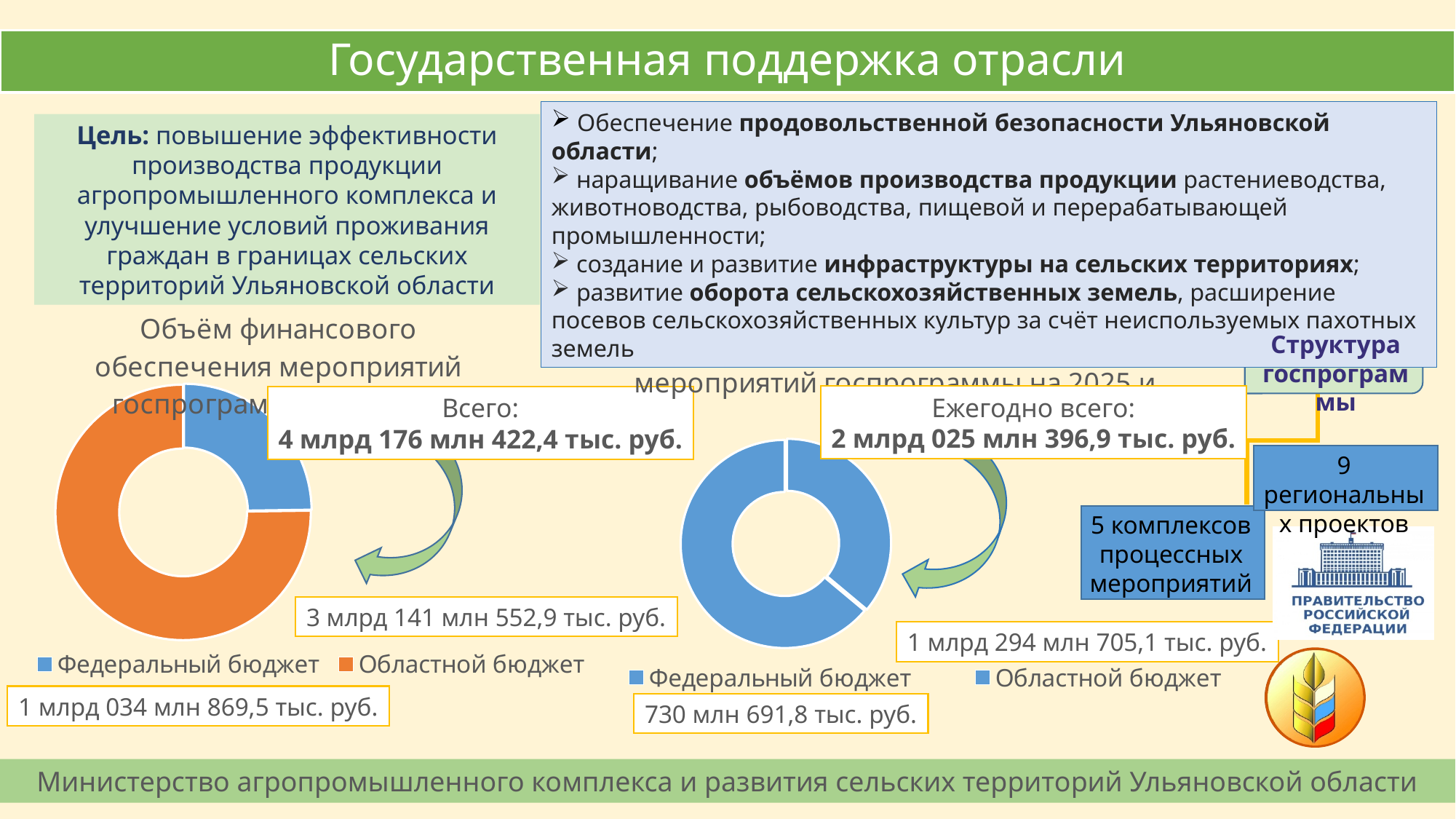
What type of chart is the left chart on the slide? doughnut chart How many slices does the right doughnut chart have? 2 On the right chart, what is the value for Федеральный бюджет? 730 млн 691,8 тыс. руб. How many series does the legend of the left chart list? 2 On the left chart, what is the value for Областной бюджет? 3 млрд 141 млн 552,9 тыс. руб. On the right chart, what is the annual total (Ежегодно всего) shown? 2 млрд 025 млн 396,9 тыс. руб. On the right chart, which budget has the smaller share? Федеральный бюджет On the left chart, what colour represents Областной бюджет? orange On the left chart, what is the total (Всего) shown? 4 млрд 176 млн 422,4 тыс. руб. On the right chart, what is the value for Областной бюджет? 1 млрд 294 млн 705,1 тыс. руб. On the left chart, what is the value for Федеральный бюджет? 1 млрд 034 млн 869,5 тыс. руб. On the left chart, which budget has the larger share? Областной бюджет